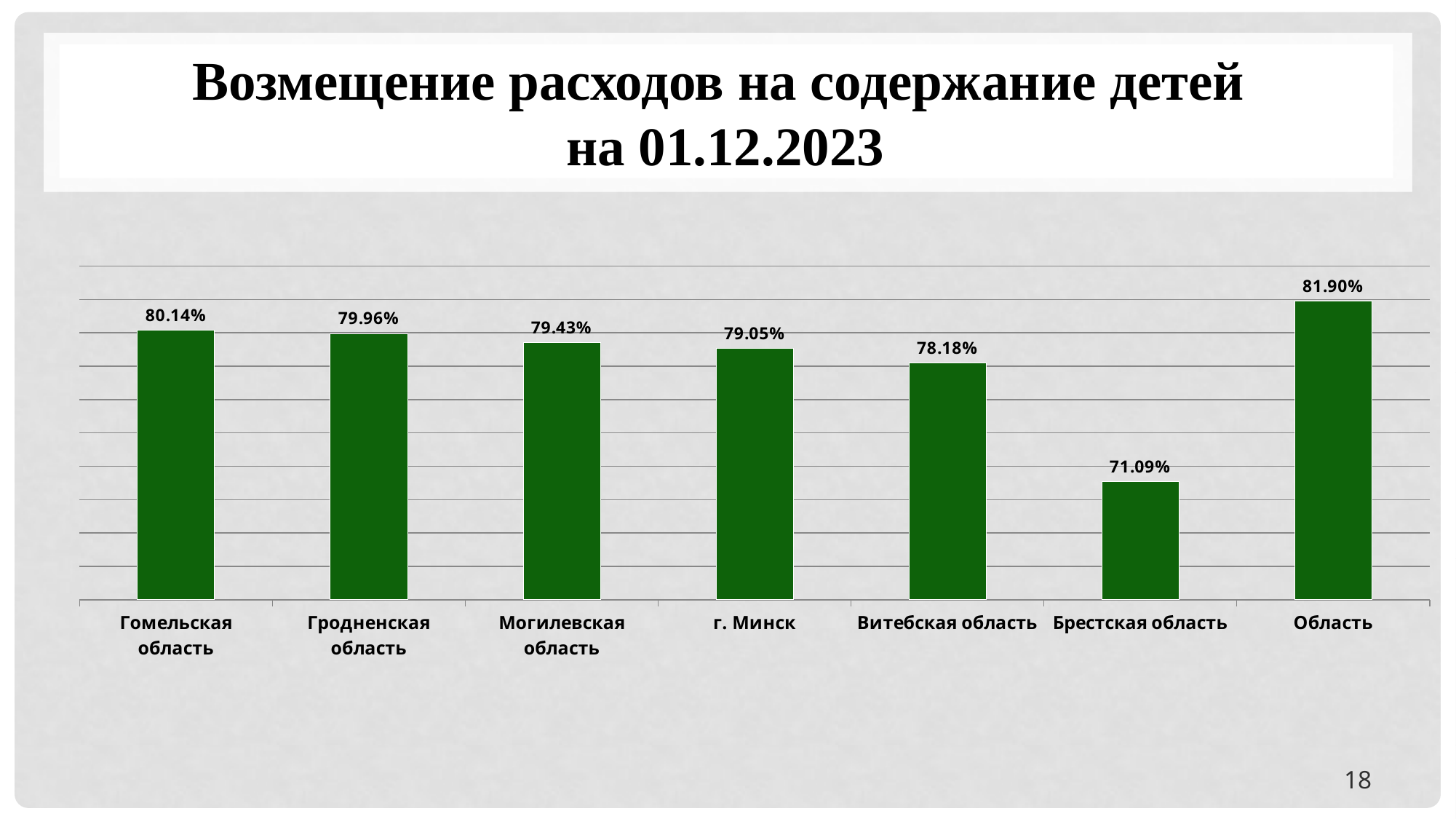
What kind of chart is shown on the slide? Bar chart What is the value for г. Минск? 79.05% What is the value for Гомельская область? 80.14% What is the difference between the values for Гомельская область and Витебская область? 1.96 percentage points What is the value for Витебская область? 78.18% Which is larger, the value for Могилевская область or the value for Витебская область? Могилевская область What is the difference between the values for Область and Брестская область? 10.81 percentage points What is the value for Брестская область? 71.09% How many categories are shown in the chart? 7 Which category has the lowest value? Брестская область What is the title of the slide? Возмещение расходов на содержание детей на 01.12.2023 Which category has the highest value? Область